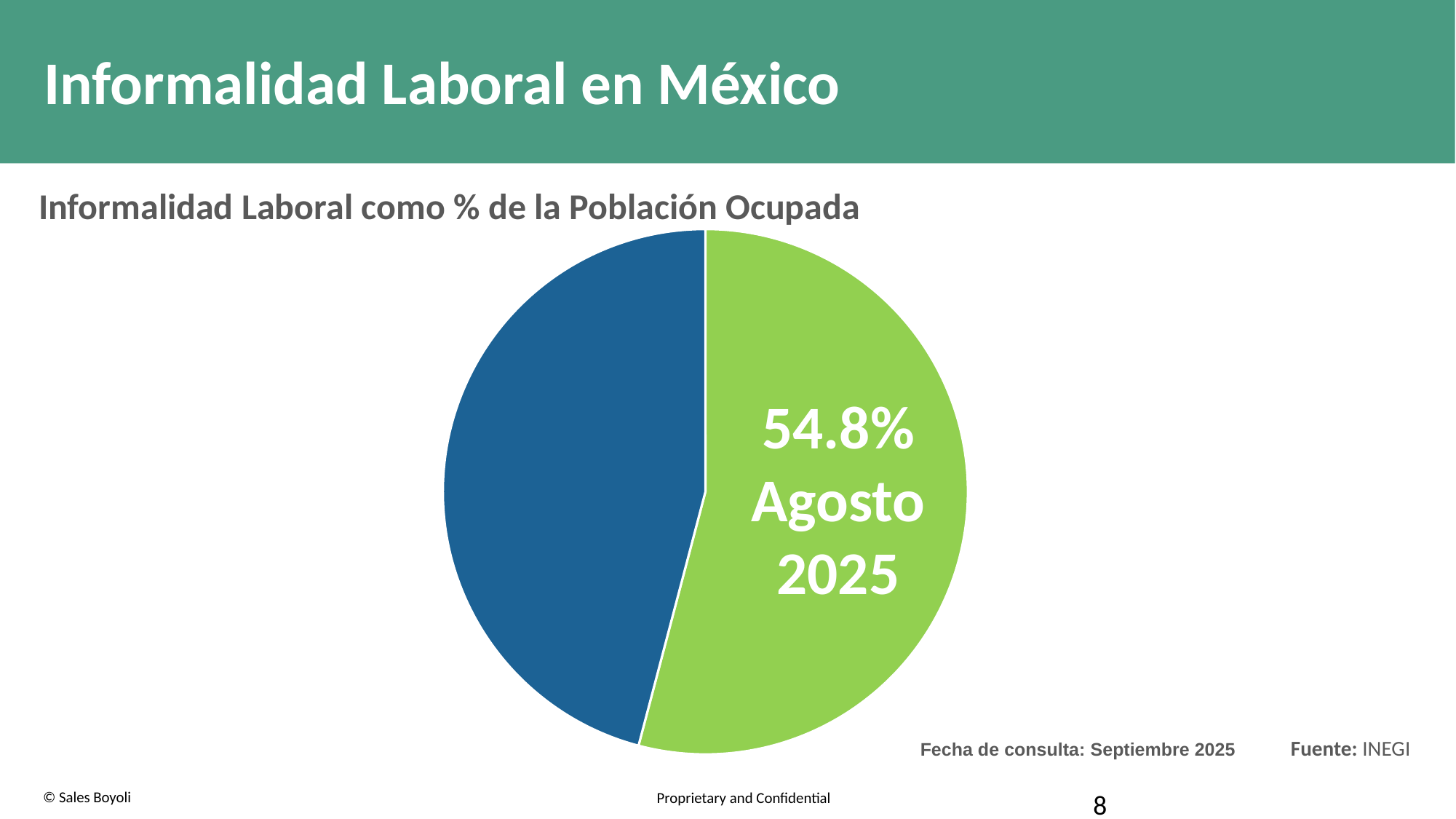
What is the title of the chart on the slide? Informalidad Laboral como % de la Población Ocupada What value is printed on the green slice of the pie chart? 54.8% What share of the pie does the slice labeled Agosto 2025 represent? 54.8% Which slice of the pie chart is the smallest? the blue slice Is the share of the green slice greater or less than 50%? greater What colour is the slice that carries the 54.8% label? green Which slice of the pie chart is larger, the green one or the blue one? the green one What kind of chart is shown on the slide? pie chart What period does the labeled slice of the pie chart refer to? Agosto 2025 Which slice of the pie chart is the largest? the green slice (54.8%) How many slices does the pie chart have? 2